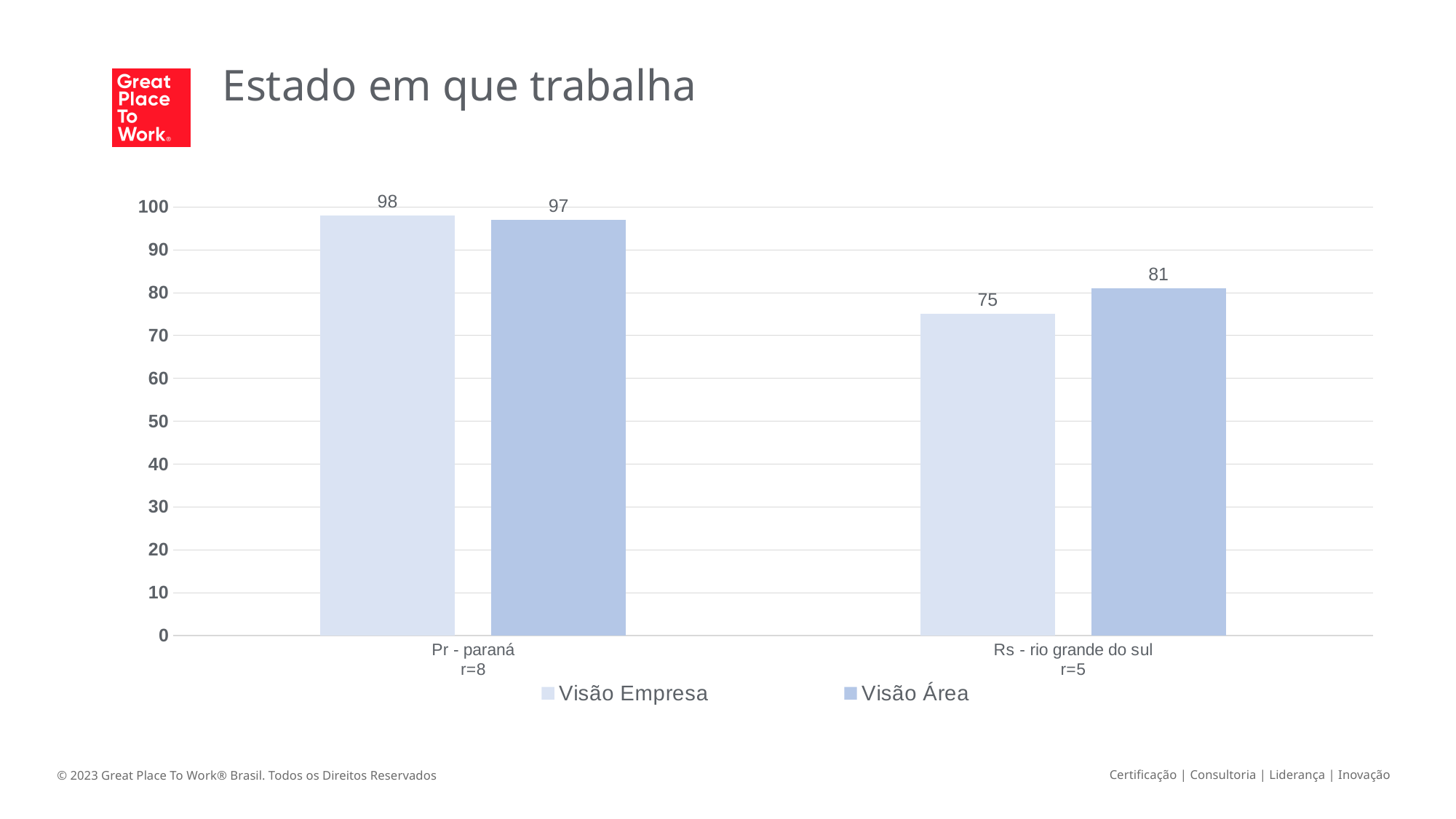
What is the Visão Empresa value for Rs - rio grande do sul? 75 How many series does the legend list? 2 What is the Visão Área value for Rs - rio grande do sul? 81 What is the difference between the Visão Empresa values for Pr - paraná and Rs - rio grande do sul? 23 How many categories are shown on the x axis? 2 Which category has the highest Visão Empresa value? Pr - paraná Which category has the lowest Visão Área value? Rs - rio grande do sul What is the difference between the Visão Área and Visão Empresa values for Rs - rio grande do sul? 6 What type of chart is shown on the slide? Bar chart What is the Visão Empresa value for Pr - paraná? 98 For Rs - rio grande do sul, which is larger: Visão Empresa or Visão Área? Visão Área What is the Visão Área value for Pr - paraná? 97